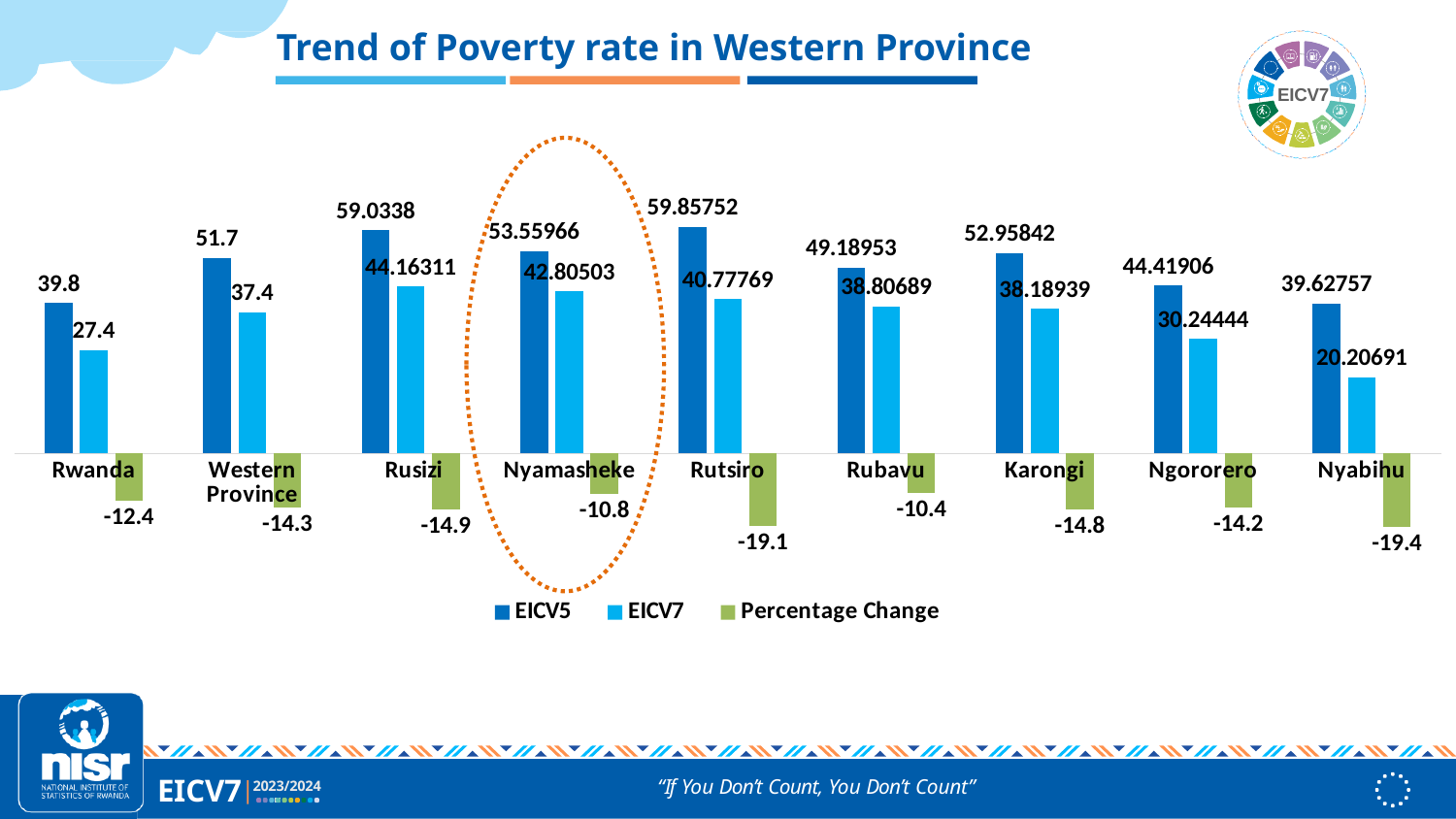
What is the difference between the EICV5 and EICV7 values for Western Province? 14.3 Which category has the lowest EICV7 poverty rate? Nyabihu What is the EICV7 value for Nyamasheke? 42.80503 What type of chart is shown on the slide? Bar chart Which is larger, the EICV7 value for Rubavu or the EICV7 value for Karongi? Rubavu Which category has the largest negative Percentage Change? Nyabihu What is the EICV5 poverty rate for Rusizi? 59.0338 What is the Percentage Change value for Rutsiro? -19.1 What is the EICV7 poverty rate for Nyabihu? 20.20691 How many categories are shown on the x axis? 9 How many series does the legend list? 3 Which category has the highest EICV5 poverty rate? Rutsiro